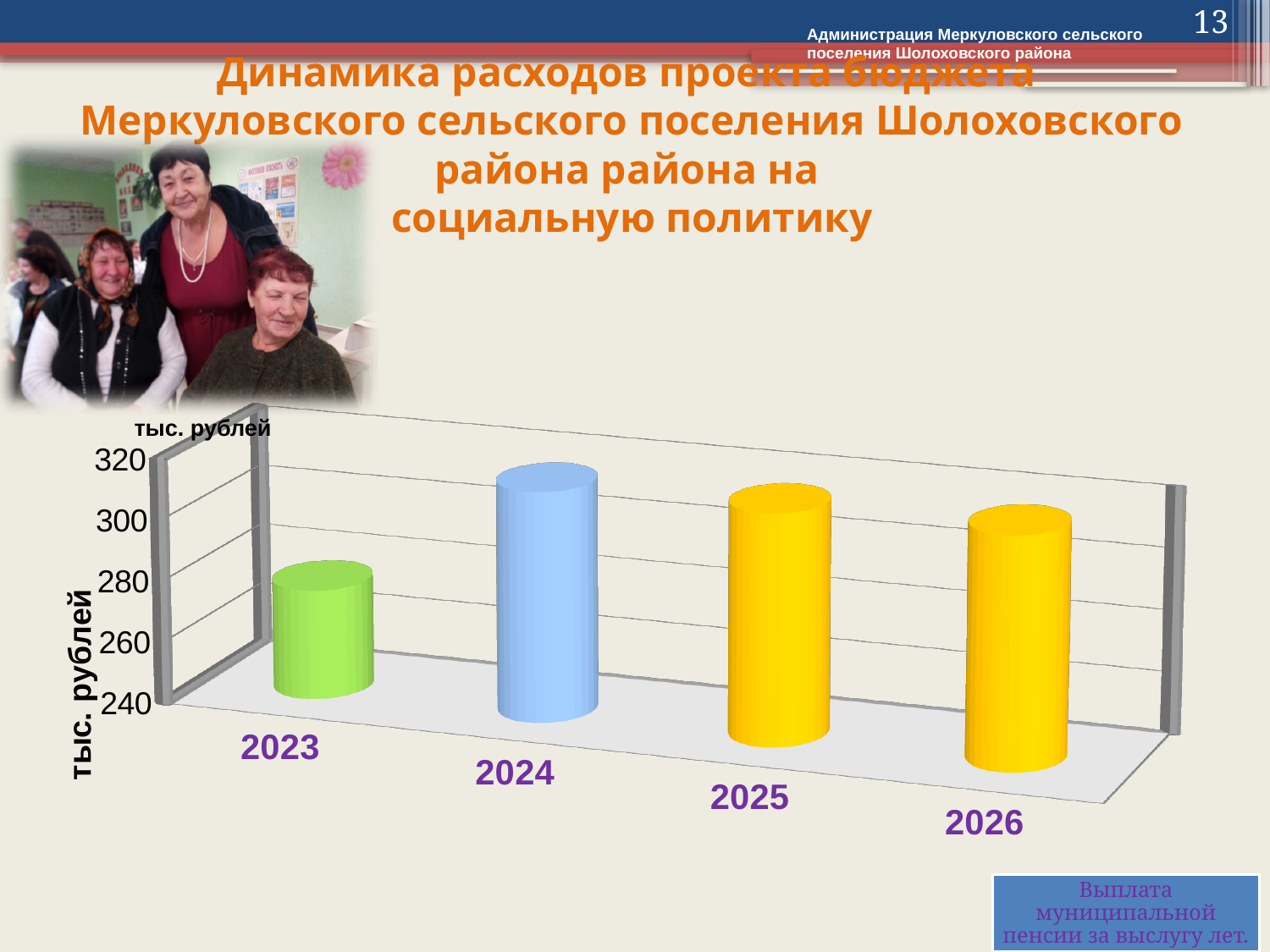
Which is larger, the value for 2023 or the value for 2025? 2025 Is the value for 2026 greater or less than 280? greater Which year has the lowest value in the chart? 2023 Is the value for 2024 greater or less than 300? greater What is the lowest tick value shown on the vertical axis? 240 What unit is given for the vertical axis of the chart? тыс. рублей How many years are shown on the x axis of the chart? 4 What kind of chart is shown on the slide? bar chart Is the value for 2023 greater or less than 300? less Does the value rise or fall from 2023 to 2024? rise